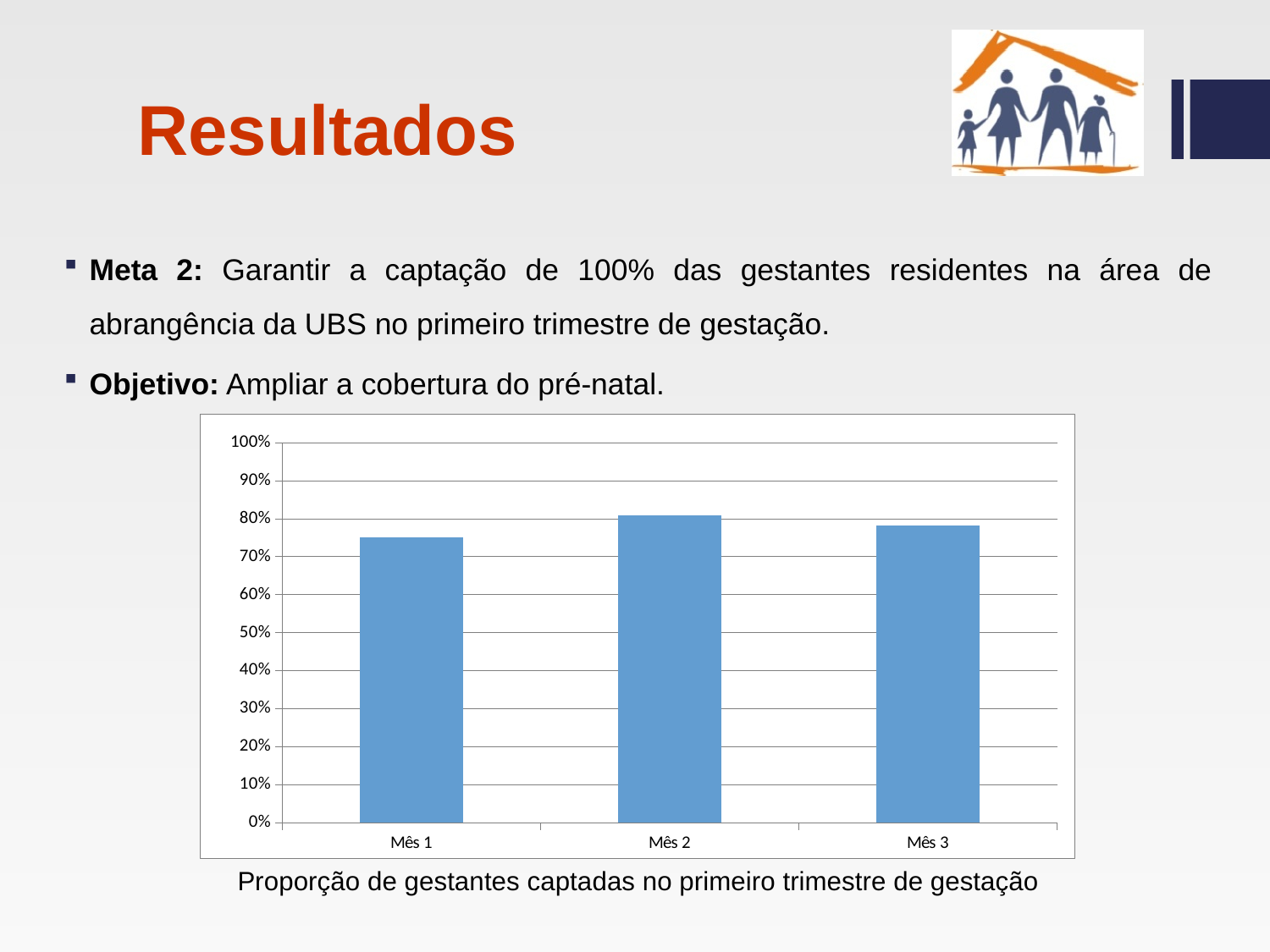
Is the value for Mês 1 greater or less than 70%? greater Does the value rise or fall from Mês 1 to Mês 2? rise What is the caption written below the chart? Proporção de gestantes captadas no primeiro trimestre de gestação Is the value for Mês 1 greater or less than 80%? less Which month has the highest bar in the chart? Mês 2 Which is larger, the value for Mês 1 or the value for Mês 3? Mês 3 Which month has the lowest bar in the chart? Mês 1 How many categories (months) are plotted in the chart? 3 Is the value for Mês 3 greater or less than 80%? less Which is larger, the value for Mês 1 or the value for Mês 2? Mês 2 What kind of chart is shown on the slide? bar chart